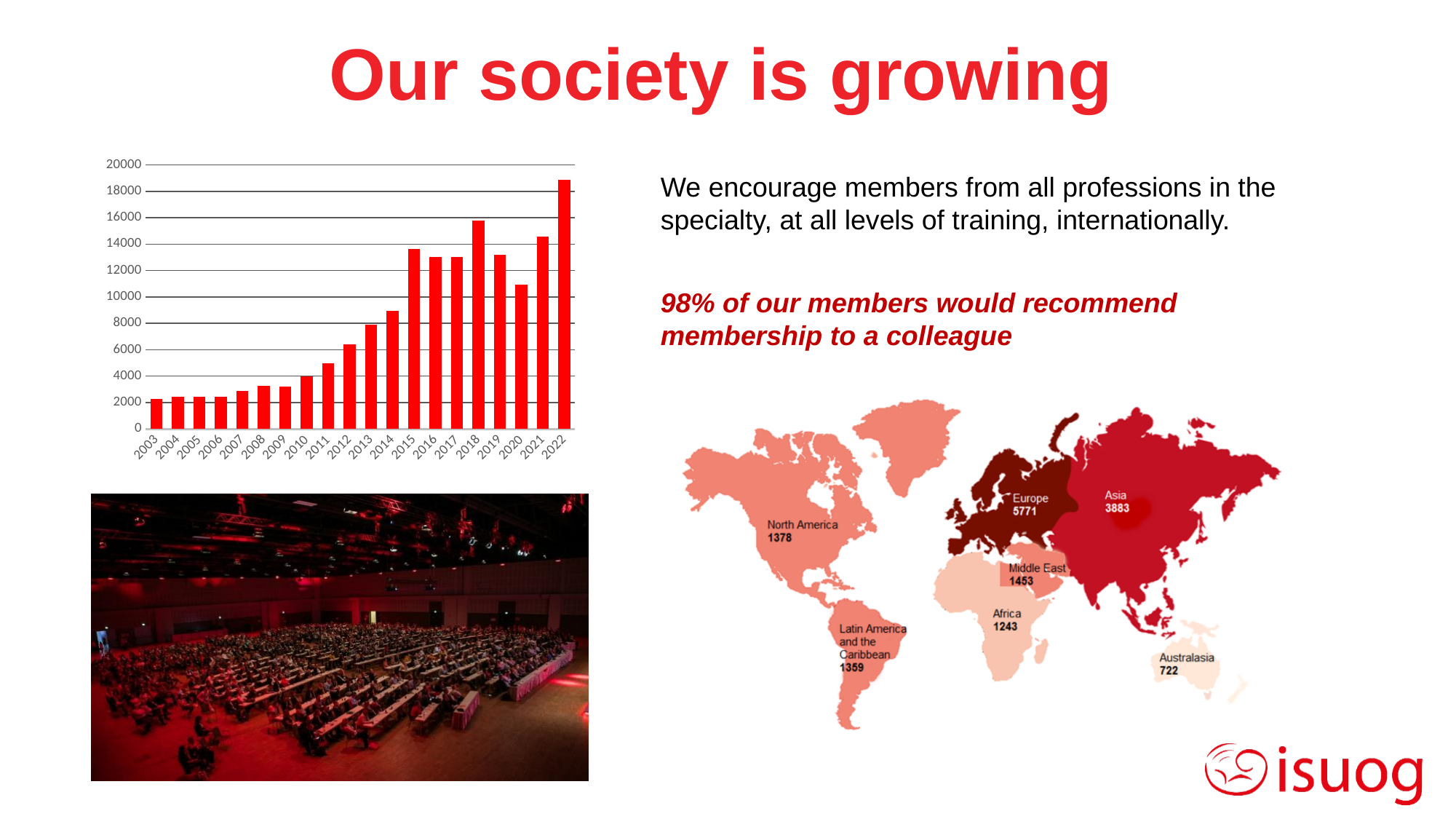
On the bar chart at the left, do the values generally rise or fall from 2003 to 2022? rise On the bar chart at the left, is the value for 2003 greater or less than 4000? less On the world map at the right, which region has the lowest value? Australasia On the bar chart at the left, how many years are shown on the x axis? 20 On the bar chart at the left, what kind of chart is shown? bar chart On the bar chart at the left, is the value for 2022 greater or less than 18000? greater On the world map at the right, what is the value shown for Europe? 5771 On the world map at the right, what is the difference between the values for Europe and Asia? 1888 On the bar chart at the left, is the value for 2015 greater or less than 12000? greater On the bar chart at the left, which year has the highest bar? 2022 On the bar chart at the left, which is larger, the value for 2019 or the value for 2020? 2019